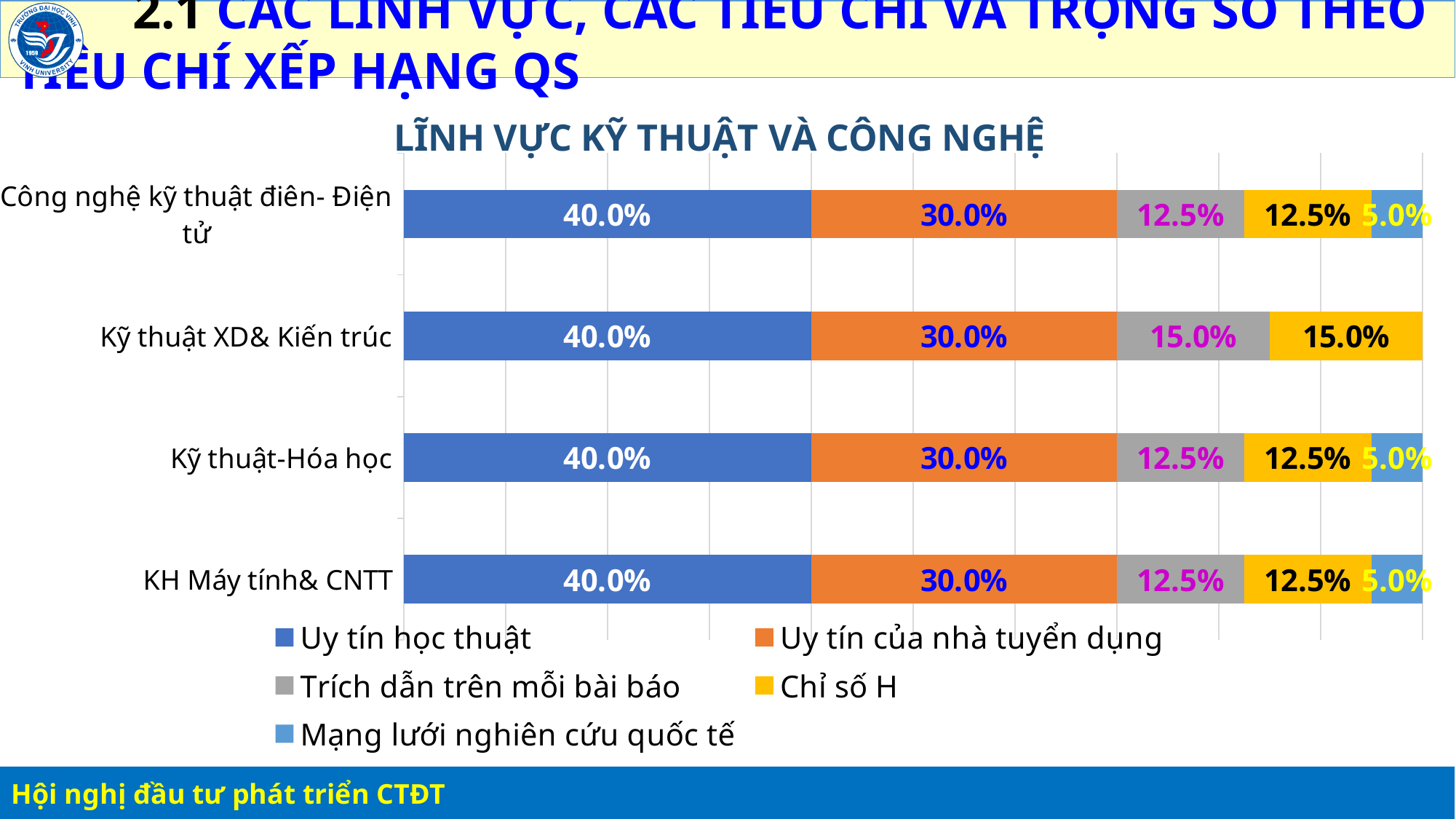
Which series has the largest value for Kỹ thuật-Hóa học? Uy tín học thuật What is the value of Chỉ số H for Kỹ thuật-Hóa học? 12.5% What is the value of Trích dẫn trên mỗi bài báo for Kỹ thuật XD& Kiến trúc? 15.0% What is the value of Mạng lưới nghiên cứu quốc tế for Công nghệ kỹ thuật điên- Điện tử? 5.0% What is the value of Uy tín học thuật for KH Máy tính& CNTT? 40.0% What is the difference between Uy tín học thuật and Uy tín của nhà tuyển dụng for KH Máy tính& CNTT? 10.0% How many series does the legend list? 5 What is the title of the chart? LĨNH VỰC KỸ THUẬT VÀ CÔNG NGHỆ What is the value of Uy tín của nhà tuyển dụng for Kỹ thuật XD& Kiến trúc? 30.0% What kind of chart is shown on the slide? Stacked bar chart Which is larger for Kỹ thuật XD& Kiến trúc: Trích dẫn trên mỗi bài báo or Uy tín của nhà tuyển dụng? Uy tín của nhà tuyển dụng How many categories are plotted on the chart? 4